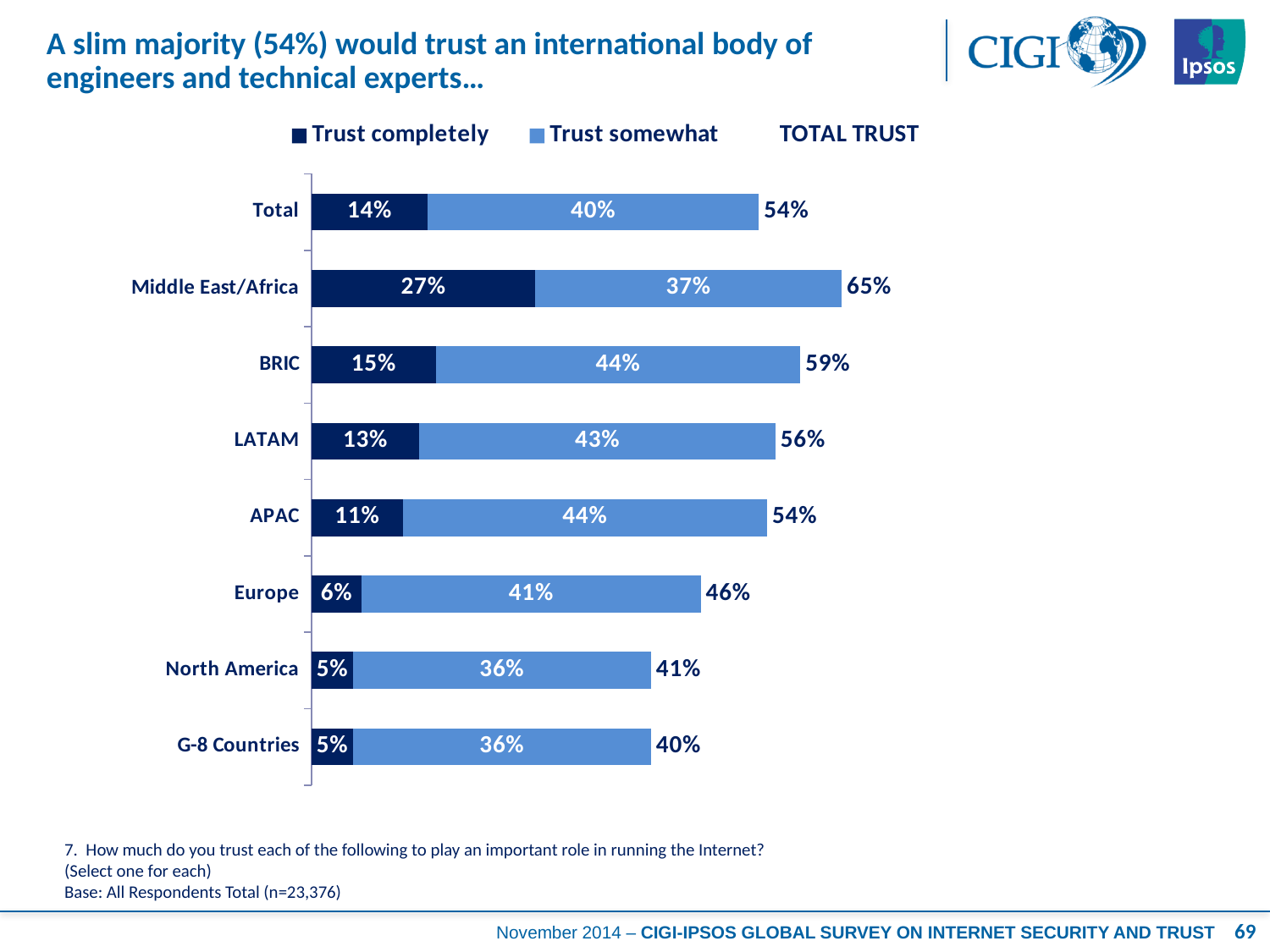
What is the 'Trust somewhat' value for BRIC? 44% What is the difference between the 'Trust completely' values for Middle East/Africa and APAC? 16% How many categories are shown on the chart? 8 Which has a larger 'Trust somewhat' value, LATAM or North America? LATAM What is the 'Trust completely' value for Middle East/Africa? 27% Which colour represents 'Trust completely' in the legend? Dark blue Which region has the highest TOTAL TRUST value? Middle East/Africa What is the total of the stacked bar for LATAM? 56% What kind of chart is shown on the slide? Stacked bar chart What is the TOTAL TRUST value for Europe? 46% Which category has the lowest TOTAL TRUST value? G-8 Countries How many series does the legend list? 3